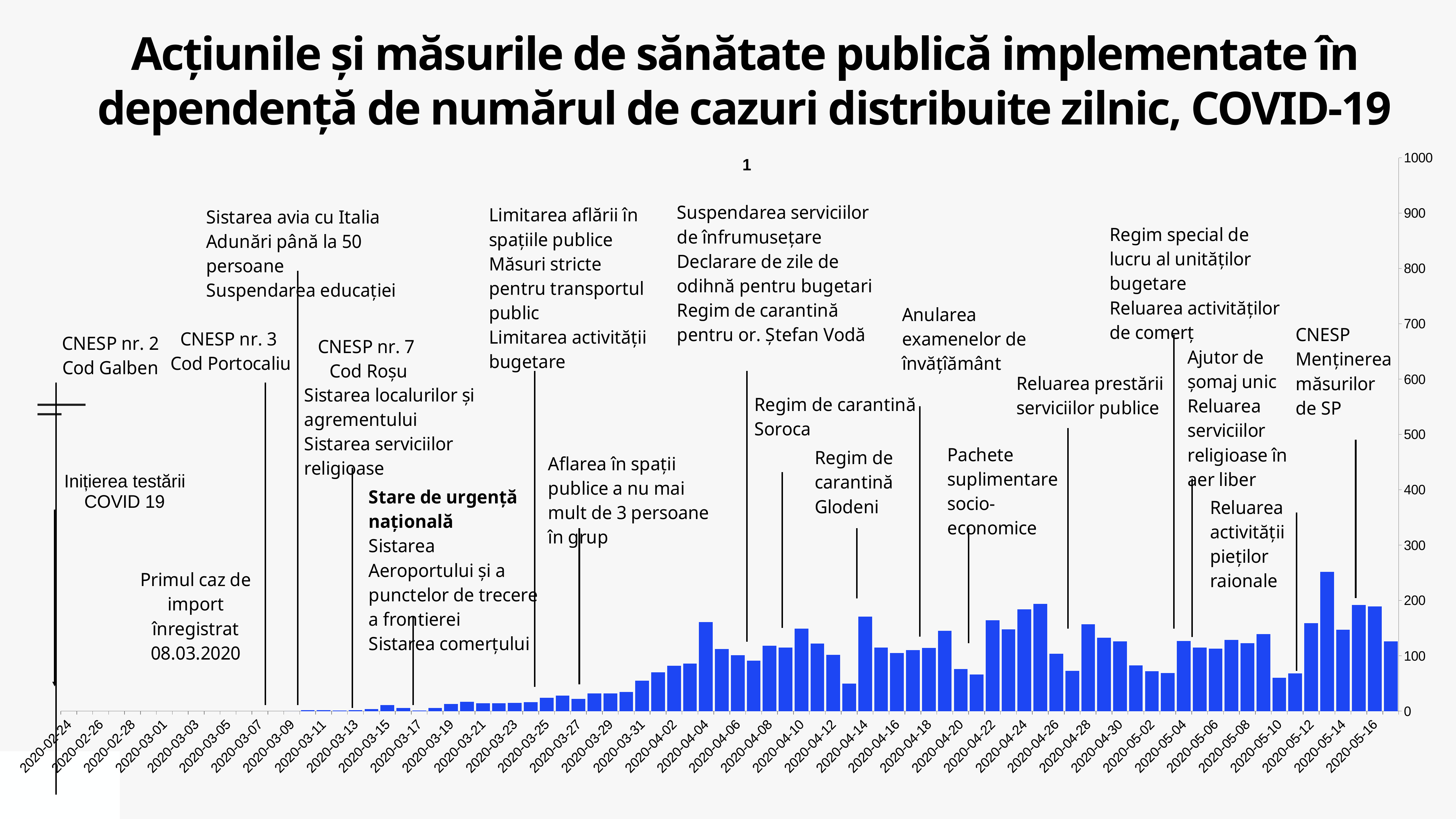
Which has the larger value, 2020-04-14 or 2020-04-20? 2020-04-14 What kind of chart is shown on the slide? bar chart Is the value for 2020-03-31 greater or less than 100? less What is the highest value shown on the vertical axis? 1000 Is the tallest bar in the chart greater or less than 200? greater What is the title of the slide? Acțiunile și măsurile de sănătate publică implementate în dependență de numărul de cazuri distribuite zilnic, COVID-19 Which has the larger value, 2020-04-04 or 2020-03-01? 2020-04-04 Is the value for 2020-04-04 greater or less than 100? greater Overall, do the daily values rise or fall from February to May along the x axis? rise